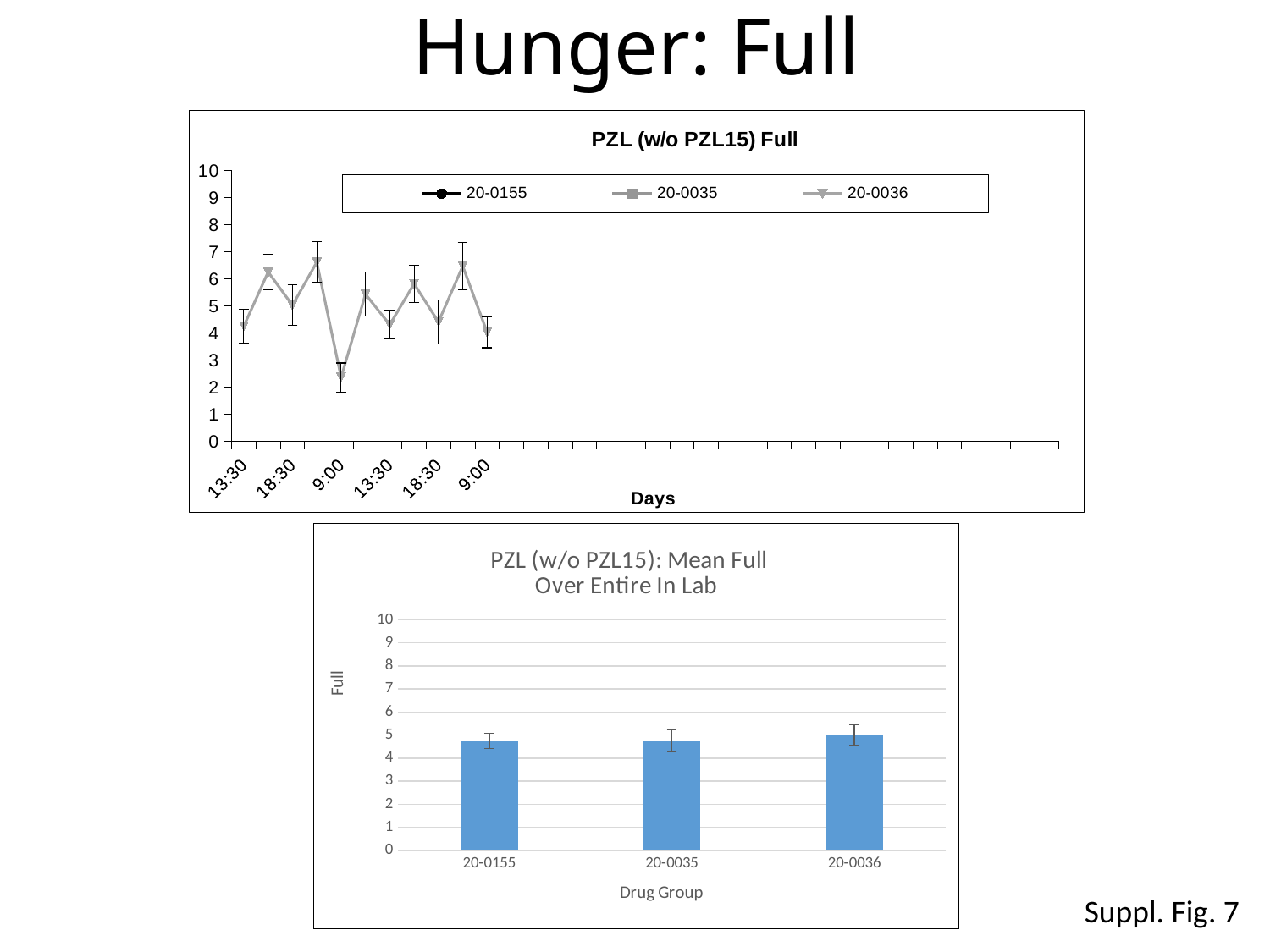
What type of chart is the bottom chart, 'PZL (w/o PZL15): Mean Full Over Entire In Lab'? bar chart What is the x-axis title of the bottom chart, 'PZL (w/o PZL15): Mean Full Over Entire In Lab'? Drug Group What is the x-axis title of the top chart, 'PZL (w/o PZL15) Full'? Days In the bottom chart, 'PZL (w/o PZL15): Mean Full Over Entire In Lab', is the value for 20-0035 greater or less than 4? greater How many series does the legend of the top chart, 'PZL (w/o PZL15) Full', list? 3 How many drug groups are shown on the x axis of the bottom chart, 'PZL (w/o PZL15): Mean Full Over Entire In Lab'? 3 What type of chart is the top chart, 'PZL (w/o PZL15) Full'? line chart In the bottom chart, 'PZL (w/o PZL15): Mean Full Over Entire In Lab', which drug group has the highest bar? 20-0036 In the top chart, 'PZL (w/o PZL15) Full', is the lowest point on the line greater or less than 3? less In the bottom chart, 'PZL (w/o PZL15): Mean Full Over Entire In Lab', is the value for 20-0155 greater or less than 5? less